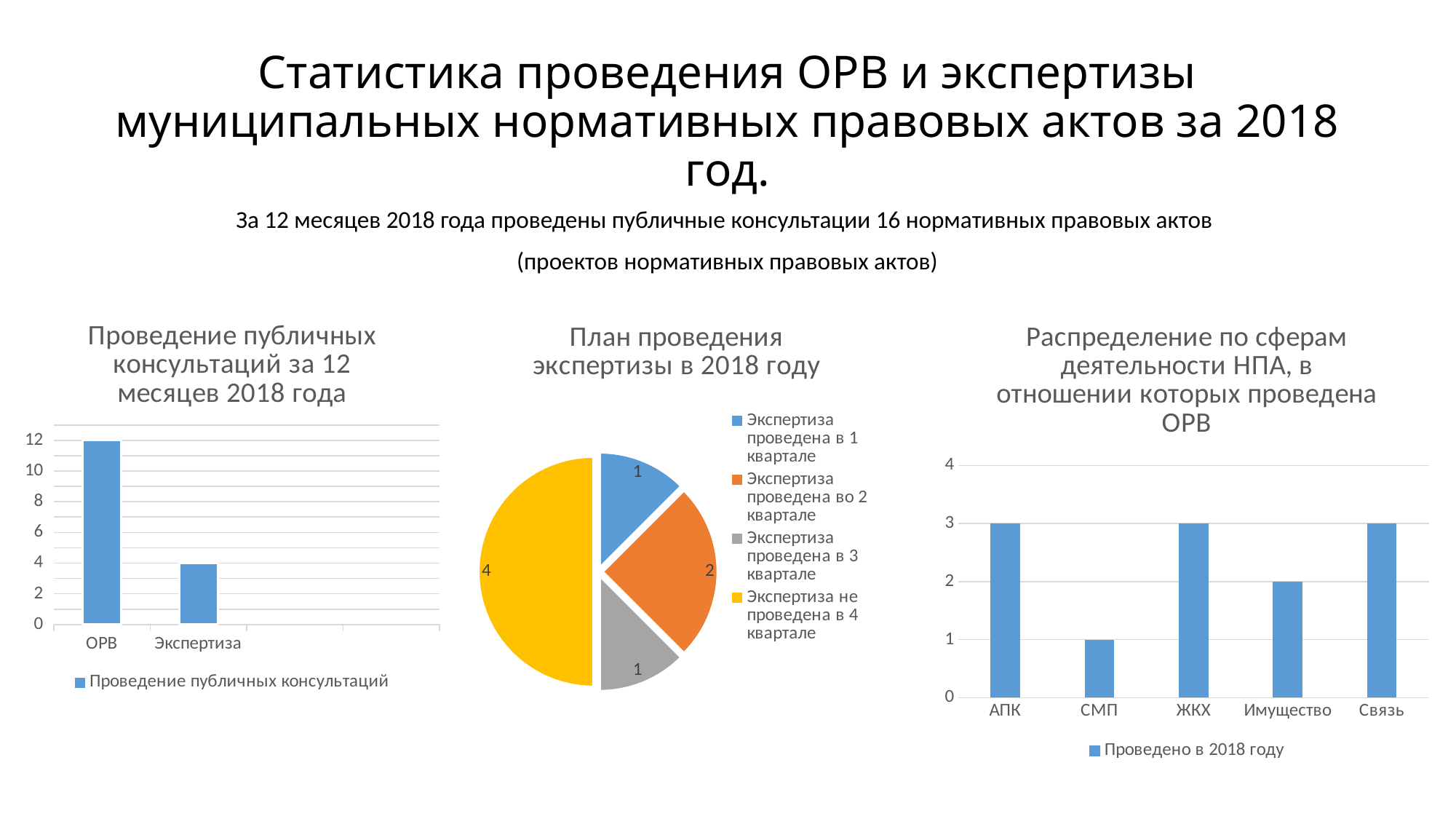
In the chart 'Распределение по сферам деятельности НПА, в отношении которых проведена ОРВ', what is the value for СМП? 1 In the chart 'Распределение по сферам деятельности НПА, в отношении которых проведена ОРВ', which is larger, the value for Имущество or the value for Связь? Связь In the chart 'Проведение публичных консультаций за 12 месяцев 2018 года', what is the difference between the values for ОРВ and Экспертиза? 8 In the pie chart 'План проведения экспертизы в 2018 году', which slice is the largest? Экспертиза не проведена в 4 квартале In the chart 'Проведение публичных консультаций за 12 месяцев 2018 года', what is the value for ОРВ? 12 In the pie chart 'План проведения экспертизы в 2018 году', what is the value for 'Экспертиза проведена во 2 квартале'? 2 How many categories are shown in the chart 'Распределение по сферам деятельности НПА, в отношении которых проведена ОРВ'? 5 What kind of chart is 'План проведения экспертизы в 2018 году'? pie chart In the chart 'Распределение по сферам деятельности НПА, в отношении которых проведена ОРВ', which category has the lowest value? СМП In the chart 'Проведение публичных консультаций за 12 месяцев 2018 года', what is the value for Экспертиза? 4 How many entries does the legend of the pie chart 'План проведения экспертизы в 2018 году' list? 4 In the pie chart 'План проведения экспертизы в 2018 году', what share of the total does the slice 'Экспертиза не проведена в 4 квартале' represent? 50%